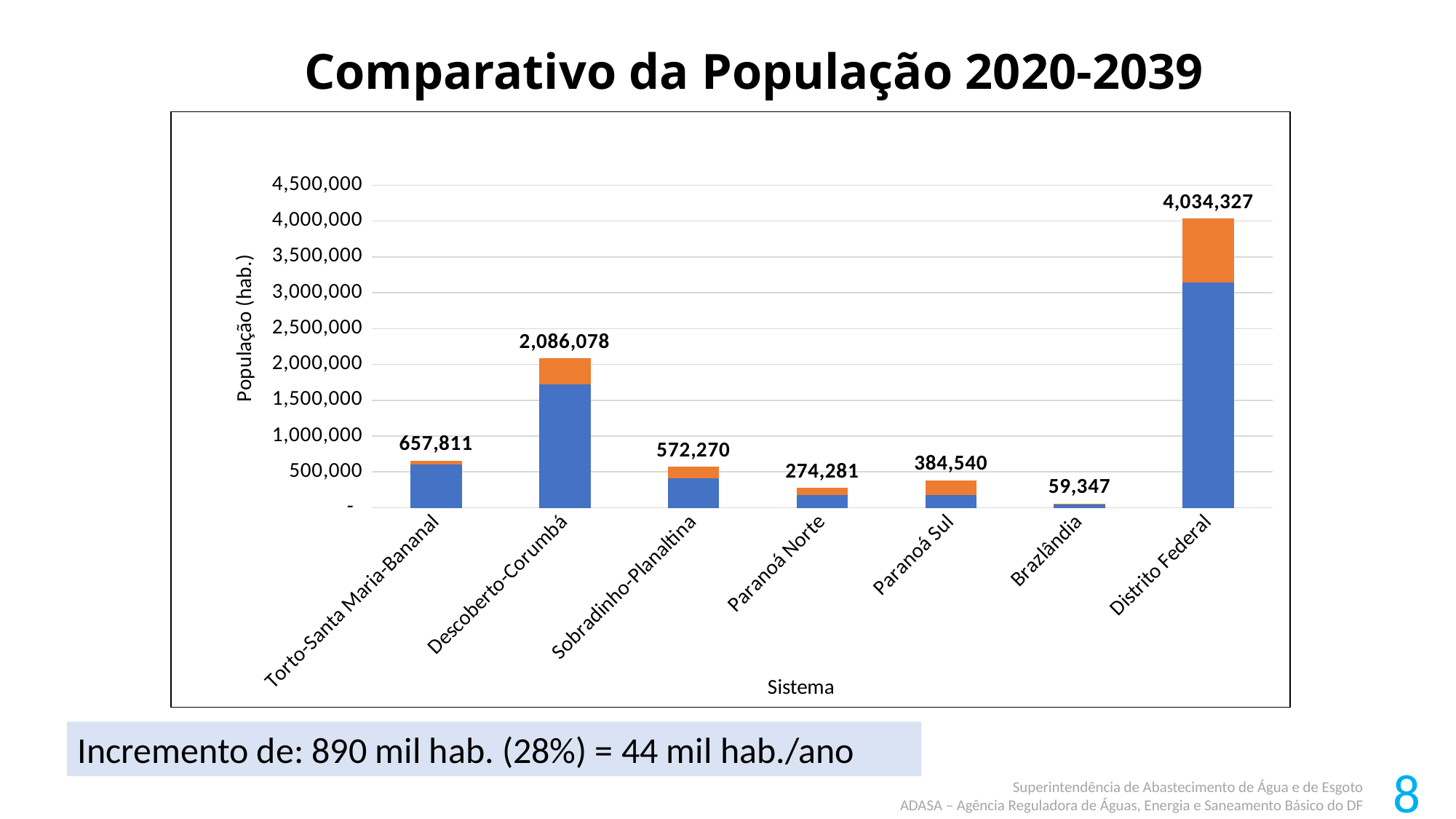
Which system has the highest total population shown? Distrito Federal What is the total value shown for Paranoá Norte? 274,281 How many systems (categories) are shown on the x axis? 7 What is the total value shown for Distrito Federal? 4,034,327 What is the total value shown for Brazlândia? 59,347 What is the title of the vertical axis? População (hab.) What is the total value shown for Descoberto-Corumbá? 2,086,078 What kind of chart is shown on the slide? Stacked bar chart What is the difference between the totals for Torto-Santa Maria-Bananal and Sobradinho-Planaltina? 85,541 Which is larger, the total for Paranoá Sul or the total for Paranoá Norte? Paranoá Sul Is the blue (lower) segment of the Distrito Federal bar greater or less than 3,000,000? greater Which system has the lowest total population shown? Brazlândia